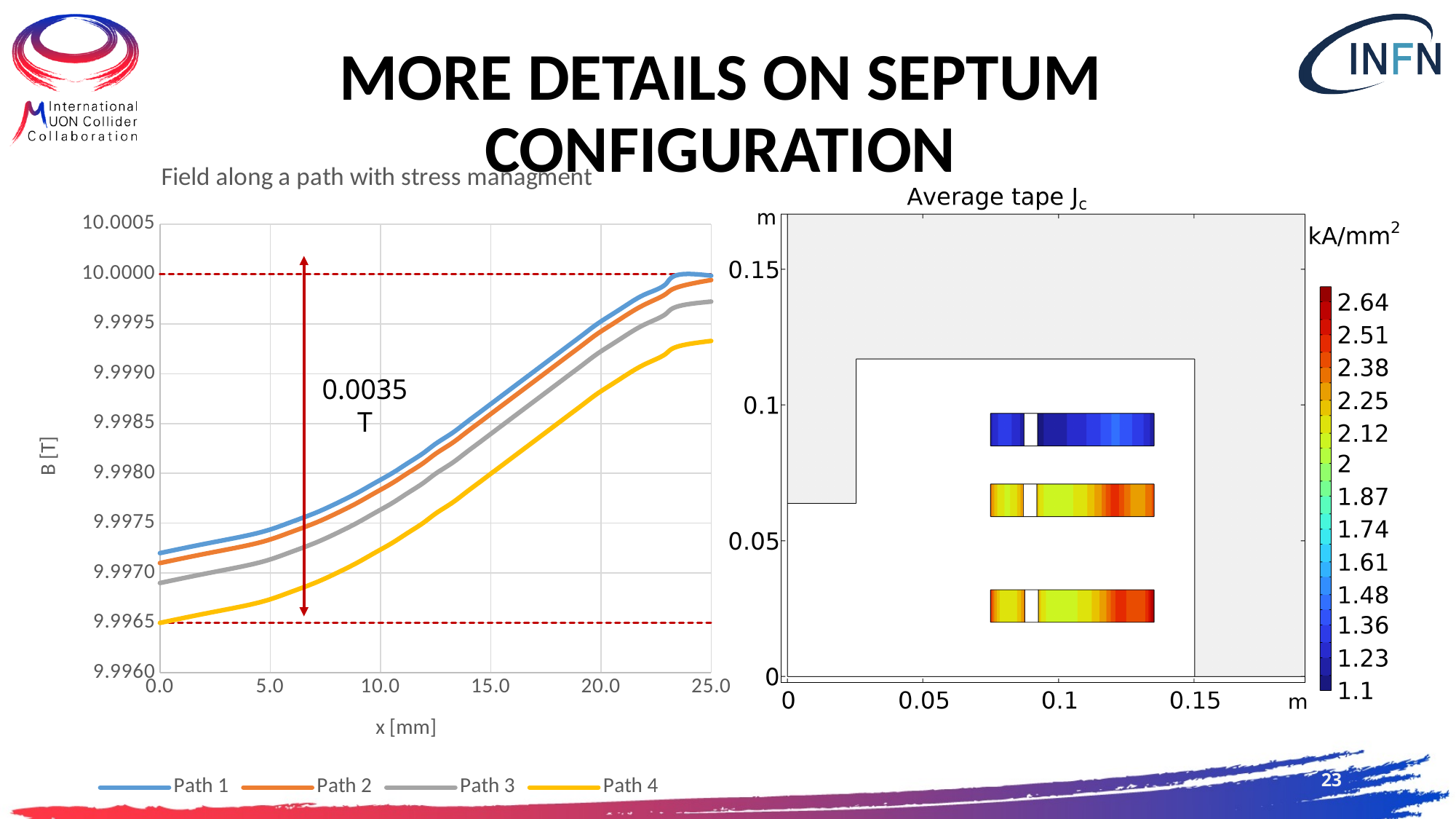
How many series does the legend of the 'Field along a path with stress managment' chart list? 4 What kind of chart is the 'Field along a path with stress managment' chart? line chart What is the label of the x axis of the 'Field along a path with stress managment' chart? x [mm] In the 'Field along a path with stress managment' chart, which path has the lowest values across the x range? Path 4 What field difference is annotated by the red double arrow in the 'Field along a path with stress managment' chart? 0.0035 T In the 'Field along a path with stress managment' chart, is the value of Path 1 at x = 25.0 mm greater or less than 9.9995? greater In the 'Average tape Jc' chart, what is the lowest value shown on the colour bar? 1.1 In the 'Field along a path with stress managment' chart, which is larger at x = 0.0 mm: Path 1 or Path 4? Path 1 In the 'Field along a path with stress managment' chart, do the values of Path 1 rise or fall as x increases? rise In the 'Average tape Jc' chart, what is the highest value shown on the colour bar? 2.64 In the 'Field along a path with stress managment' chart, is the value of Path 4 at x = 0.0 mm greater or less than 9.9970? less In the 'Field along a path with stress managment' chart, which path has the highest values across the x range? Path 1